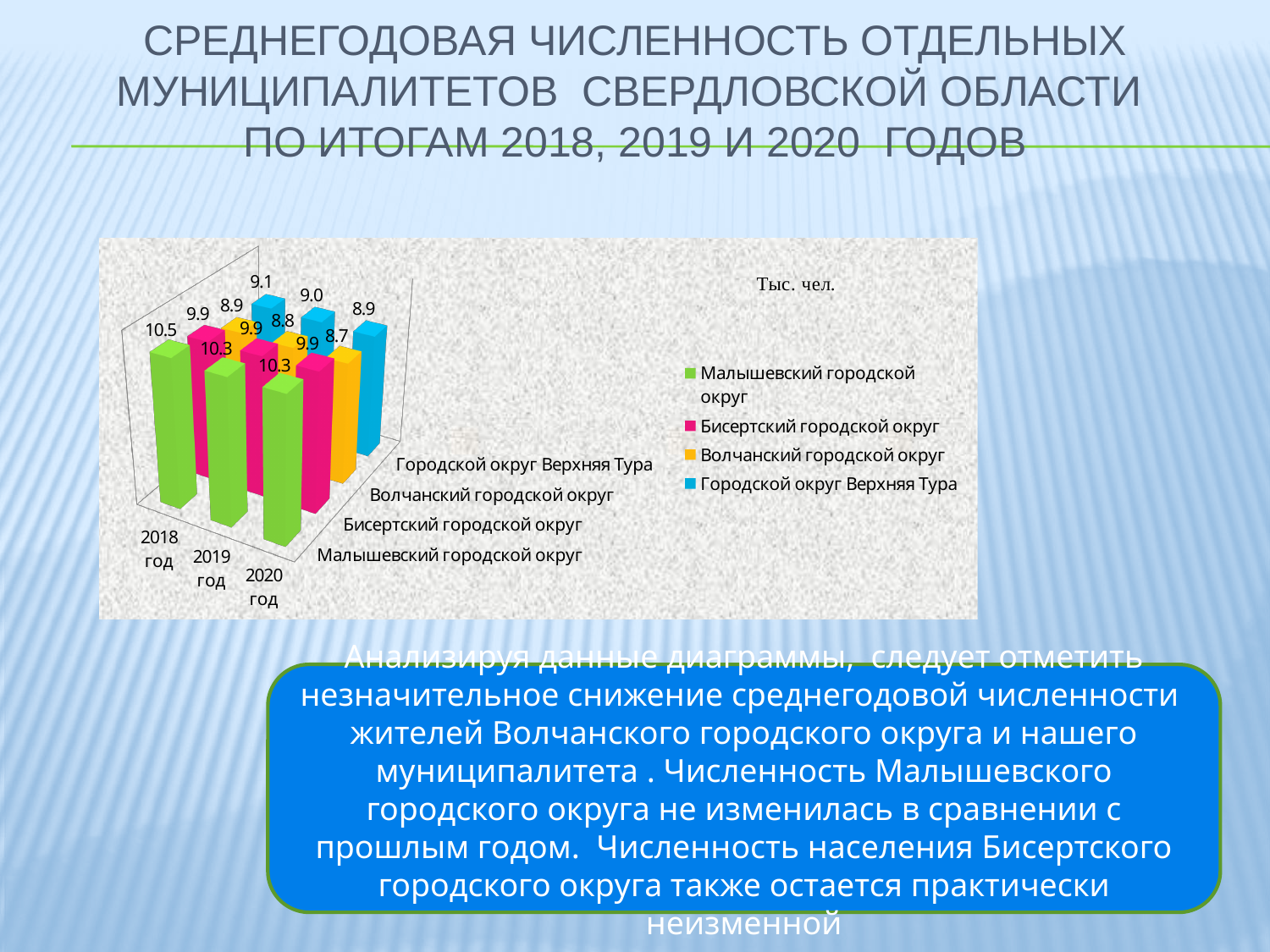
Which municipality has the highest value in 2018? Малышевский городской округ What is the value for Малышевский городской округ in 2018? 10.5 What is the value for Волчанский городской округ in 2020? 8.7 How many years (categories) are shown on the chart? 3 What kind of chart is shown on the slide? bar chart What is the value for Городской округ Верхняя Тура in 2018? 9.1 What is the value for Малышевский городской округ in 2020? 10.3 What is the difference between the 2018 and 2020 values for Малышевский городской округ? 0.2 Which municipality has the lowest value in 2020? Волчанский городской округ What unit is indicated on the chart? Тыс. чел. Do the values for Волчанский городской округ rise or fall from 2018 to 2020? fall How many series does the legend list? 4